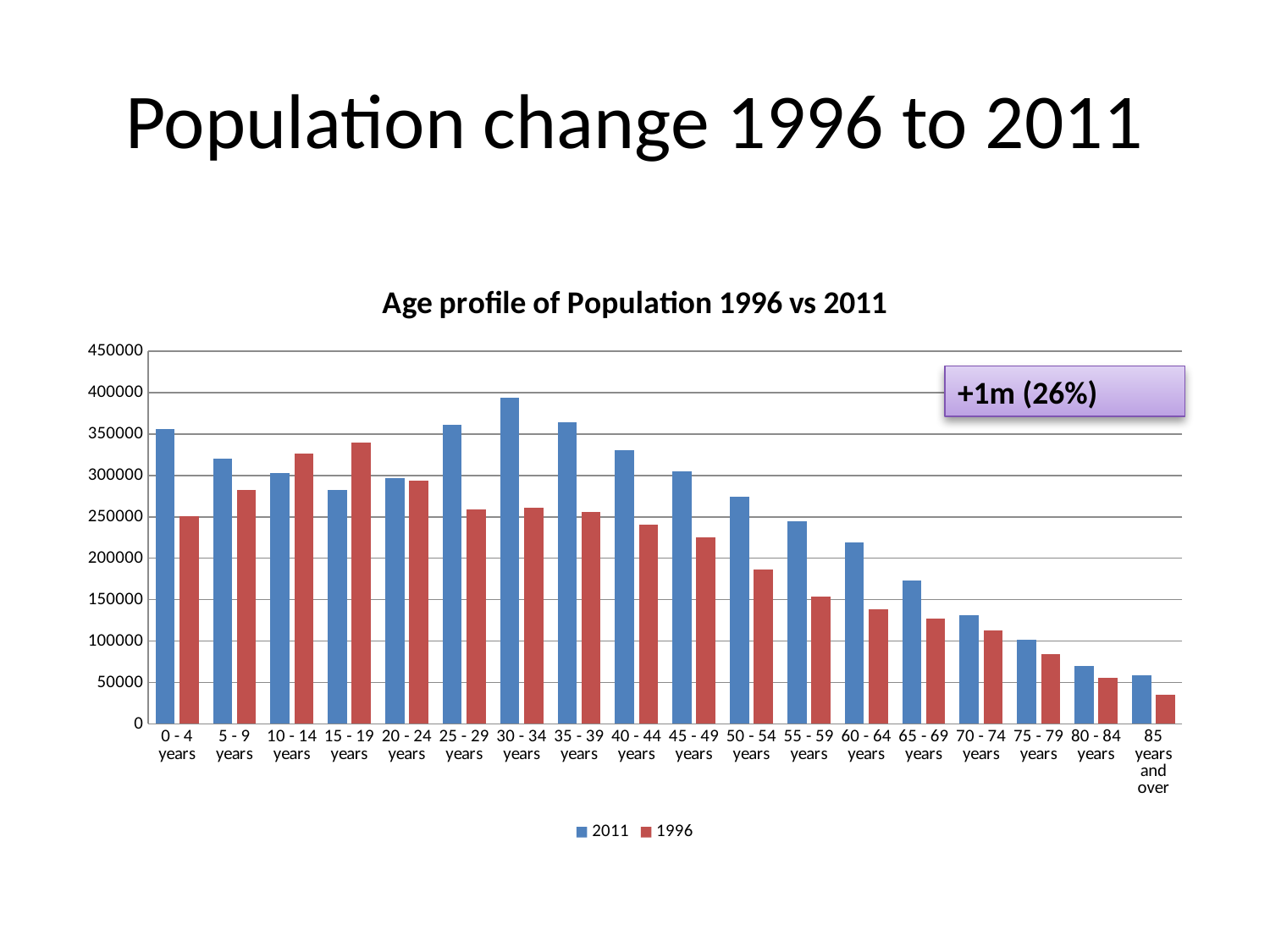
Which age group has the lowest value for the 2011 series? 85 years and over Which age group has the highest value for the 1996 series? 15 - 19 years Do the 2011 values rise or fall across the age groups from 30 - 34 years to 85 years and over? fall For the 15 - 19 years age group, which series has the larger value, 2011 or 1996? 1996 What kind of chart is shown on the slide? Bar chart How many series does the legend list? 2 For the 0 - 4 years age group, which series has the larger value, 2011 or 1996? 2011 Which age group has the highest value for the 2011 series? 30 - 34 years Is the 1996 value for 50 - 54 years greater or less than 200000? less What is the title of the chart? Age profile of Population 1996 vs 2011 How many age group categories are shown on the x axis? 18 Is the 2011 value for 30 - 34 years greater or less than 350000? greater